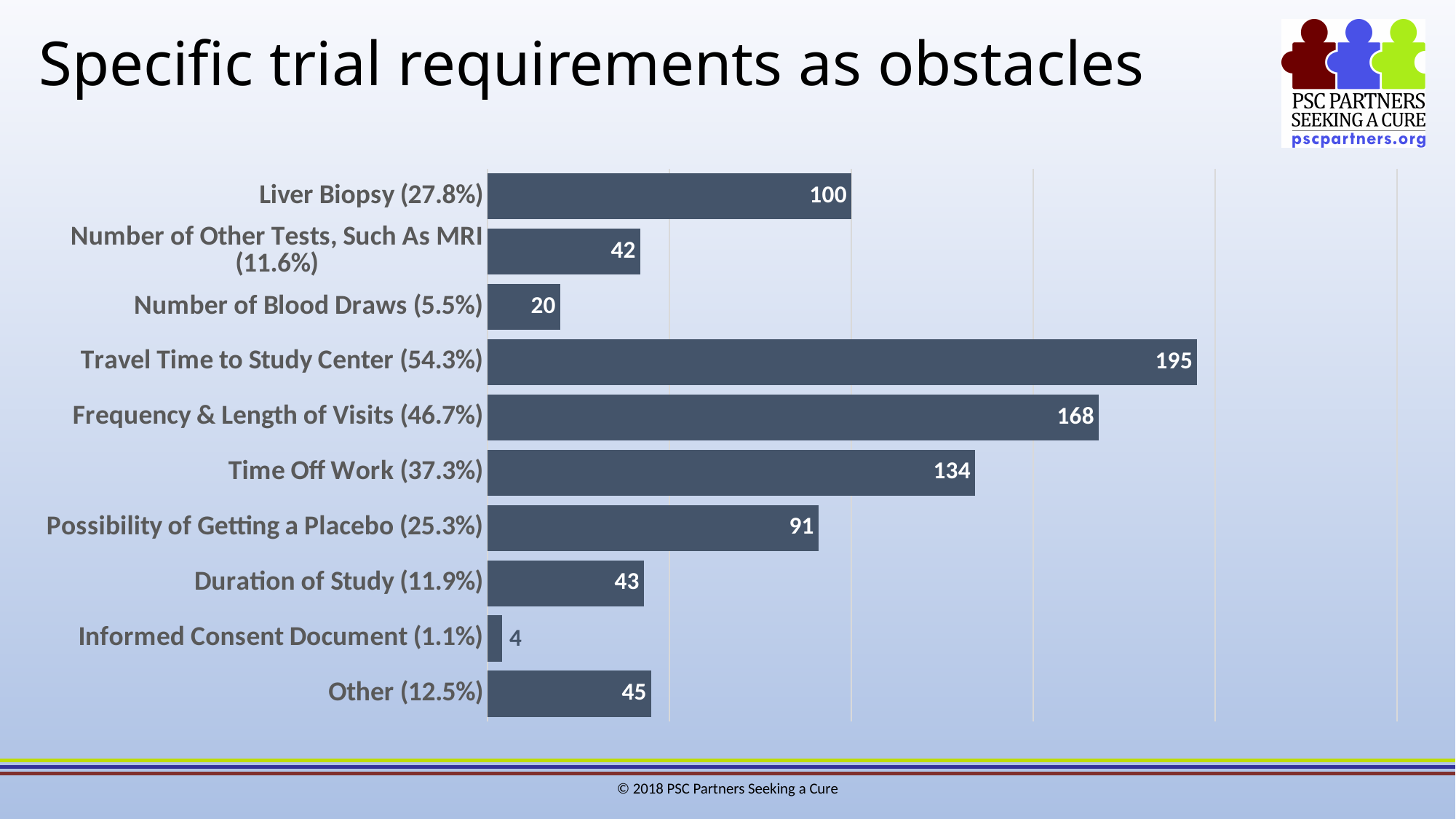
What is the value for Travel Time to Study Center? 195 What percentage is shown in the label for Time Off Work? 37.3% What is the difference between the values for Liver Biopsy and Time Off Work? 34 What kind of chart is shown on the slide? Bar chart Which is larger, the value for Duration of Study or the value for Other? Other What is the value for Number of Blood Draws? 20 Which is larger, the value for Liver Biopsy or the value for Possibility of Getting a Placebo? Liver Biopsy Which category has the highest value? Travel Time to Study Center Which category has the lowest value? Informed Consent Document What is the difference between the values for Travel Time to Study Center and Frequency & Length of Visits? 27 How many categories are shown in the chart? 10 What is the value for Possibility of Getting a Placebo? 91